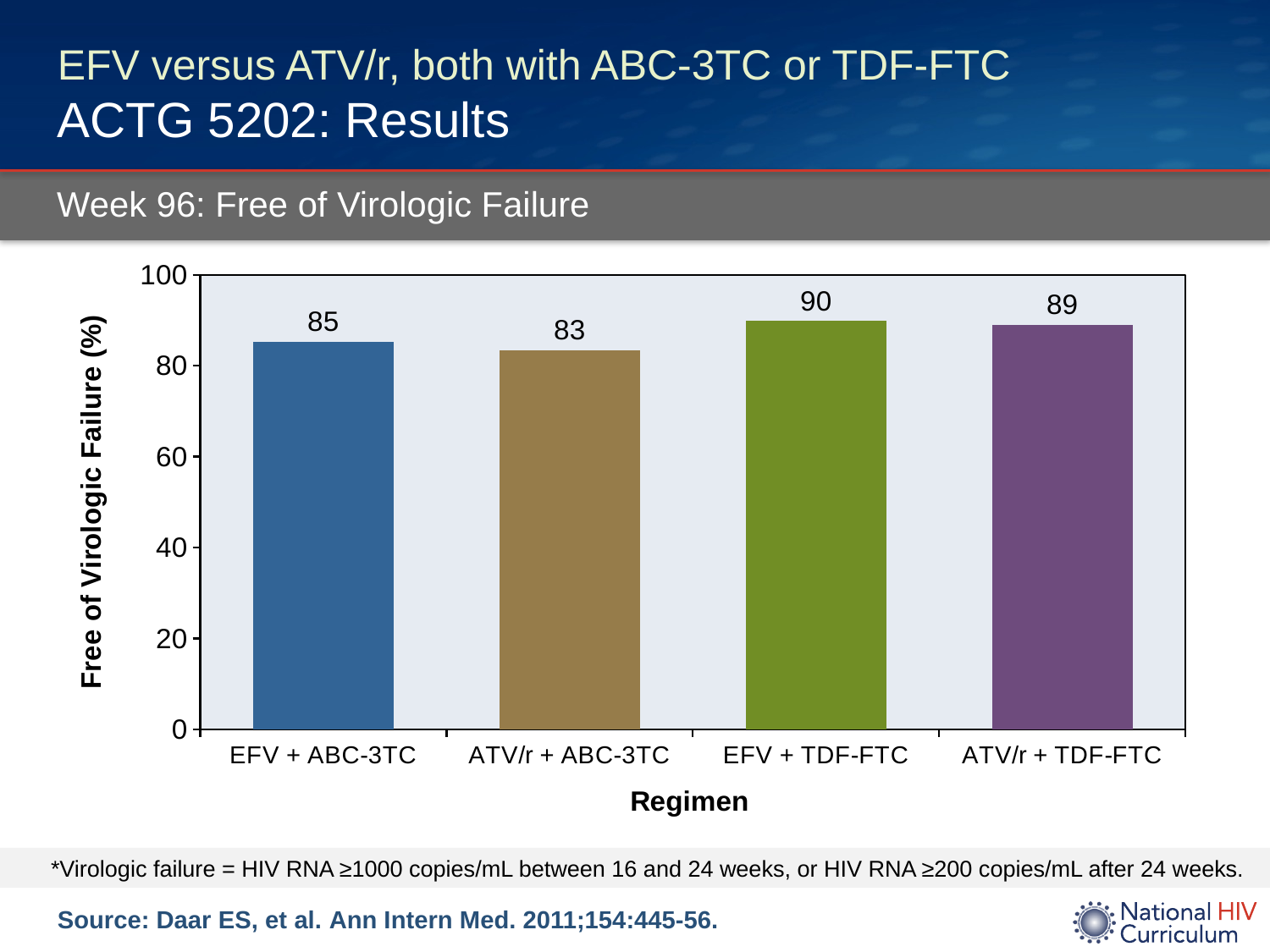
Which is larger, the value for EFV + ABC-3TC or the value for EFV + TDF-FTC? EFV + TDF-FTC What is the value for ATV/r + ABC-3TC? 83 What is the difference between the values for EFV + ABC-3TC and ATV/r + ABC-3TC? 2 What kind of chart is shown on the slide? Bar chart Which regimen has the lowest percentage free of virologic failure? ATV/r + ABC-3TC What is the value for EFV + TDF-FTC? 90 Which regimen has the highest percentage free of virologic failure? EFV + TDF-FTC How many regimens are shown on the chart? 4 What is the value for ATV/r + TDF-FTC? 89 What is the value for EFV + ABC-3TC? 85 What is the difference between the values for EFV + TDF-FTC and ATV/r + ABC-3TC? 7 What is the label of the y axis? Free of Virologic Failure (%)